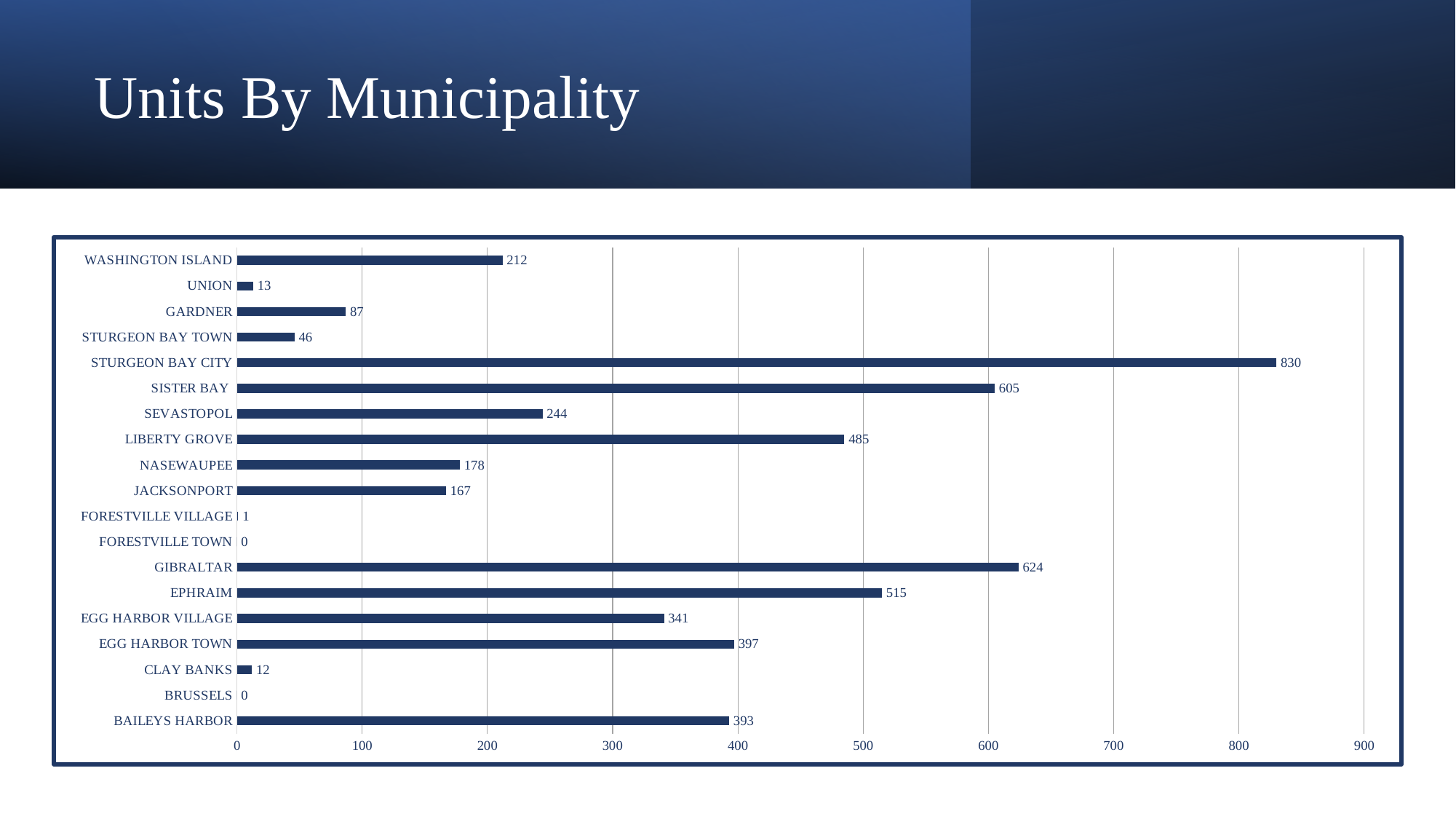
What is the value for Liberty Grove? 485 What is the value for Sturgeon Bay City? 830 How many municipalities are shown on the chart? 19 What is the title of the slide? Units By Municipality Which has a larger value, Ephraim or Liberty Grove? Ephraim What is the difference between the values for Egg Harbor Town and Baileys Harbor? 4 What kind of chart is shown on the slide? bar chart What is the value for Egg Harbor Village? 341 Which municipality has the highest value? Sturgeon Bay City Is the value for Nasewaupee greater or less than 200? less What is the difference between the values for Gibraltar and Sister Bay? 19 Which has a larger value, Washington Island or Sevastopol? Sevastopol